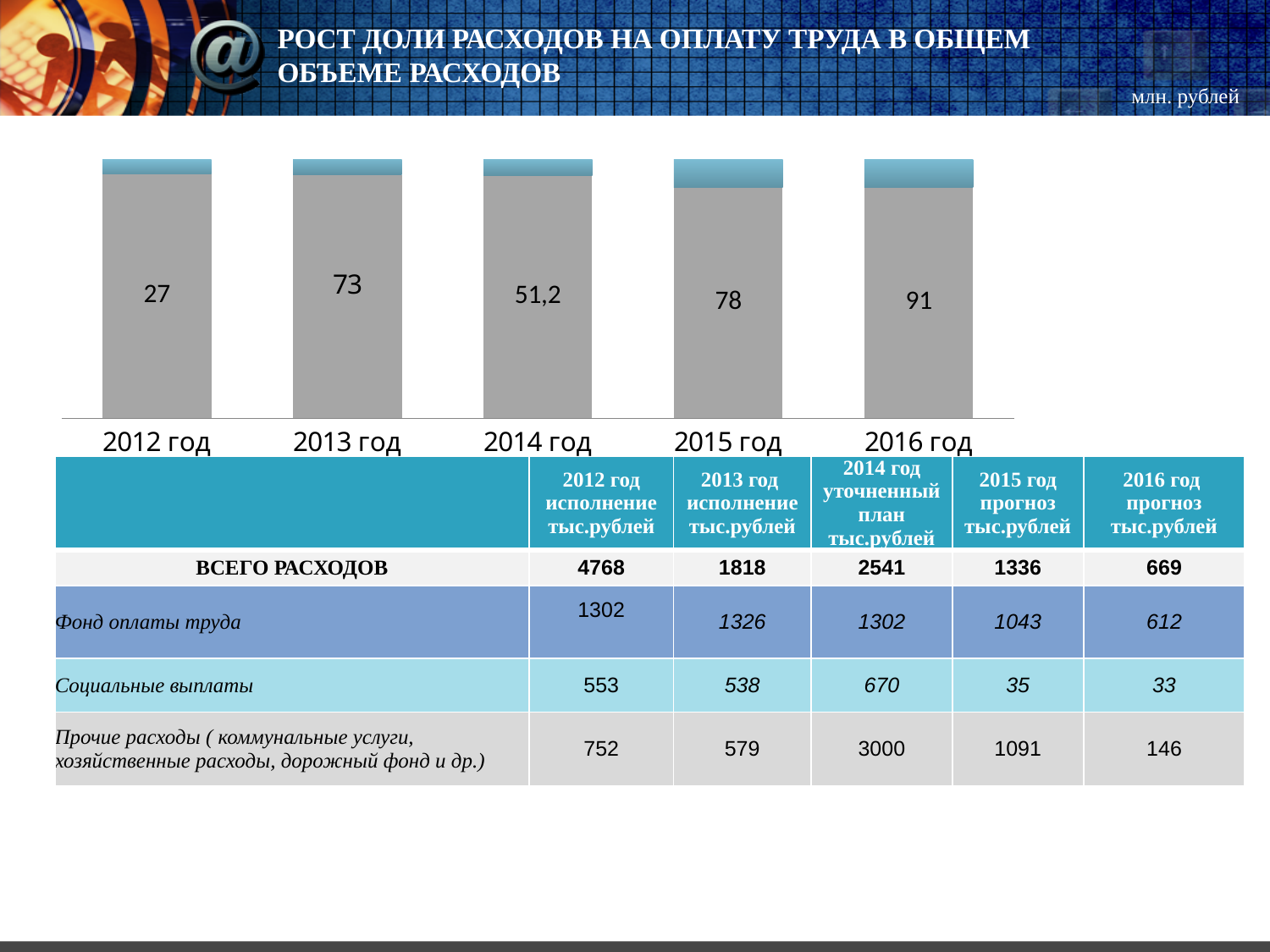
How many years are shown on the x axis of the bar chart? 5 What value is shown for 2012 год in the bar chart? 27 Which year has the lowest labelled value in the bar chart? 2012 год What value is shown for 2013 год in the bar chart? 73 What value is shown for 2015 год in the bar chart? 78 What is the difference between the labelled values for 2016 год and 2012 год in the bar chart? 64 What value is shown for 2016 год in the bar chart? 91 What kind of chart is shown on the slide? bar chart What value is shown for 2014 год in the bar chart? 51,2 Does the labelled value rise or fall from 2015 год to 2016 год in the bar chart? rise Which year has the highest labelled value in the bar chart? 2016 год Which has the larger labelled value in the bar chart, 2013 год or 2014 год? 2013 год